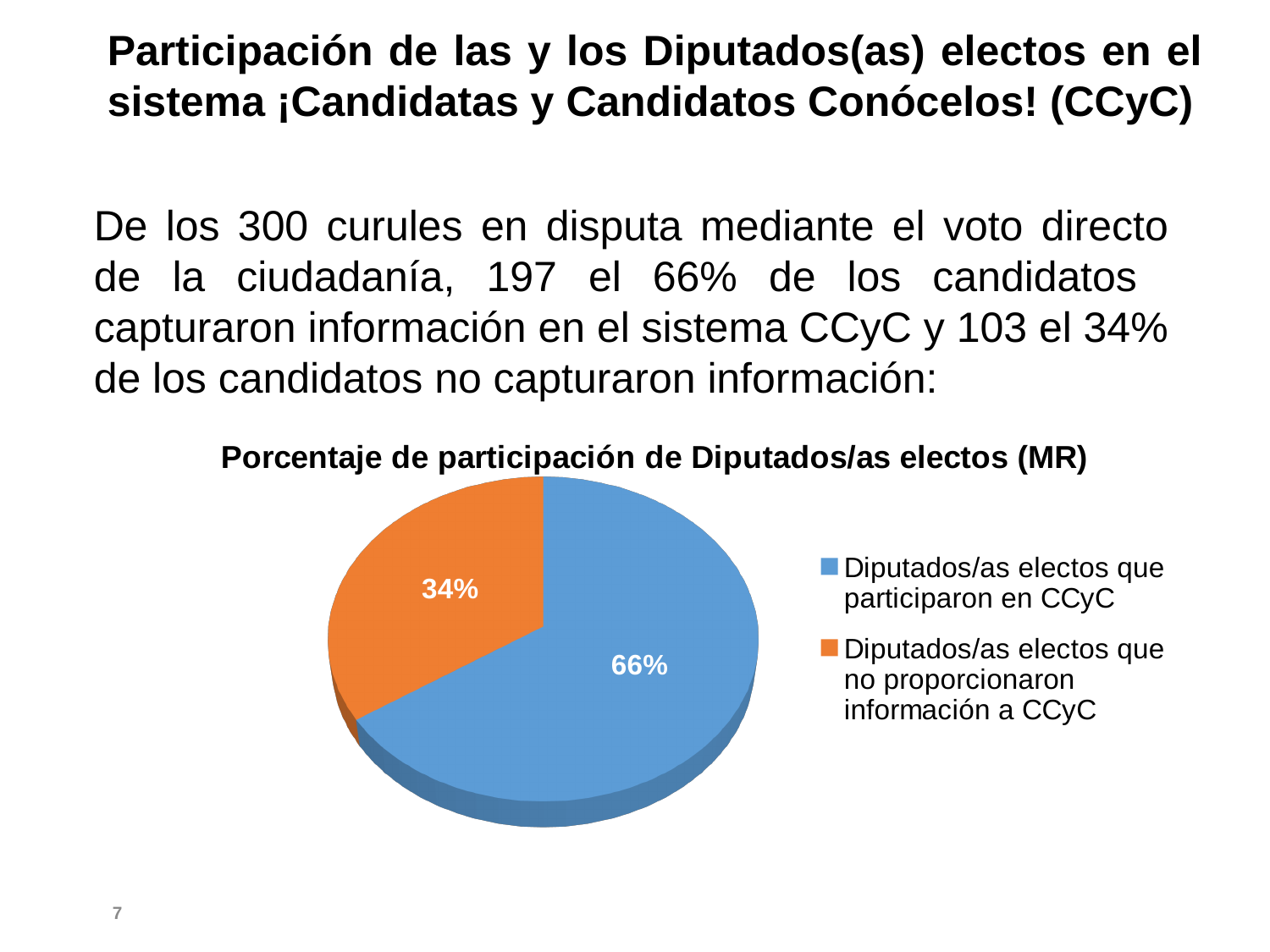
What colour is the slice for 'Diputados/as electos que no proporcionaron información a CCyC'? Orange What share of the pie is labelled for 'Diputados/as electos que no proporcionaron información a CCyC'? 34% Which slice of the pie is the largest? Diputados/as electos que participaron en CCyC What kind of chart is shown on the slide? Pie chart What share of the pie is labelled for 'Diputados/as electos que participaron en CCyC'? 66% What is the total of the two slice percentages shown on the pie? 100% Which slice of the pie is the smallest? Diputados/as electos que no proporcionaron información a CCyC What is the title of the chart? Porcentaje de participación de Diputados/as electos (MR) How many slices does the pie chart have? 2 How many entries does the legend list? 2 Which is larger: the share of Diputados/as electos que participaron en CCyC or the share of those que no proporcionaron información a CCyC? Diputados/as electos que participaron en CCyC What is the difference in percentage points between the 66% slice and the 34% slice? 32 percentage points